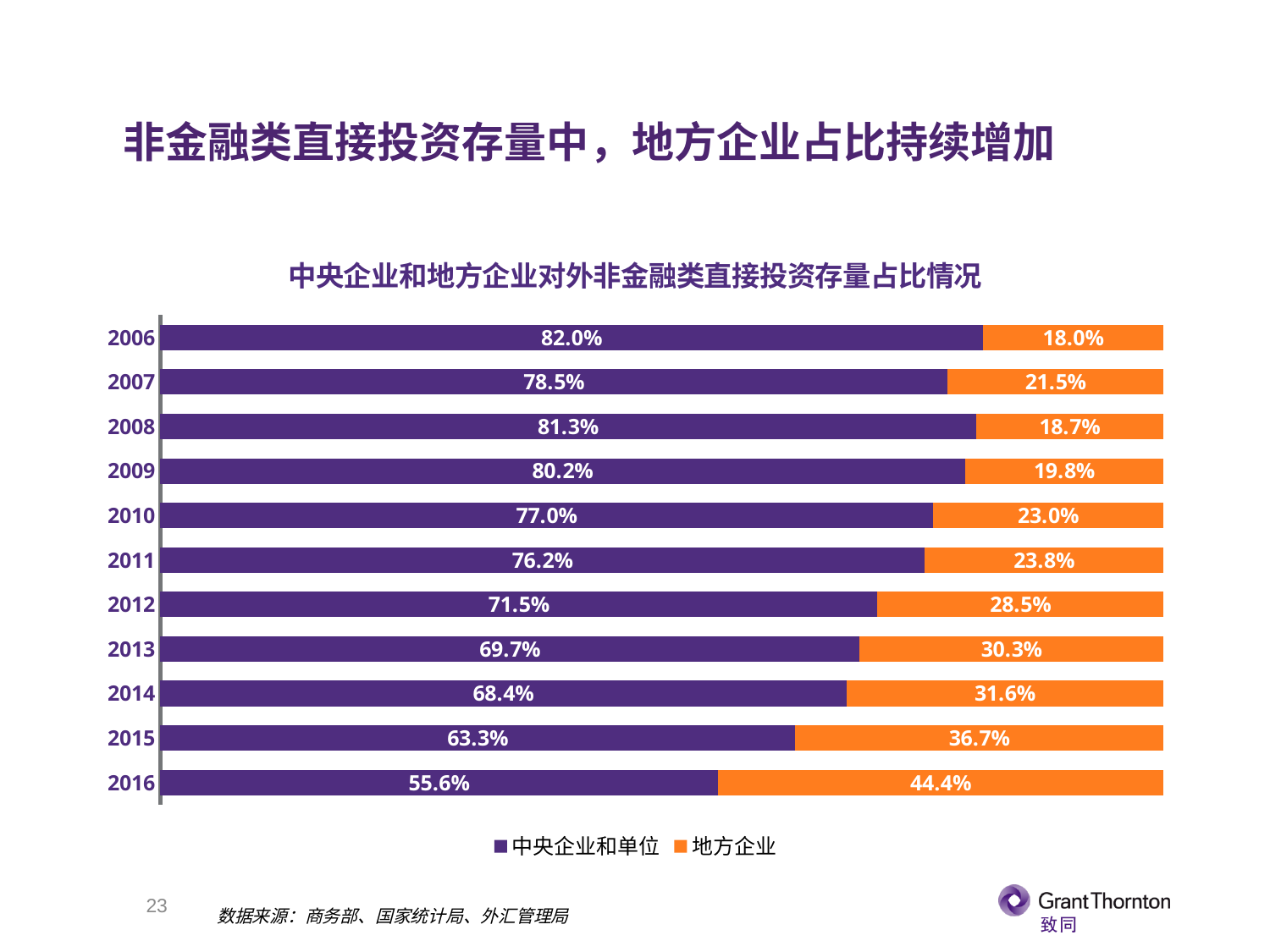
What is the title of the chart? 中央企业和地方企业对外非金融类直接投资存量占比情况 What is the value for 中央企业和单位 in 2016? 55.6% Does the share of 地方企业 generally rise or fall from 2006 to 2016? Rise What is the value for 地方企业 in 2012? 28.5% How many years are shown in the chart? 11 In which year is the share of 中央企业和单位 lowest? 2016 Which is larger in 2015: the share of 中央企业和单位 or the share of 地方企业? 中央企业和单位 In which year is the share of 地方企业 highest? 2016 What is the value for 地方企业 in 2006? 18.0% What kind of chart is shown on the slide? Stacked bar chart What is the difference between the 中央企业和单位 share in 2006 and in 2016? 26.4% How many series does the legend list? 2